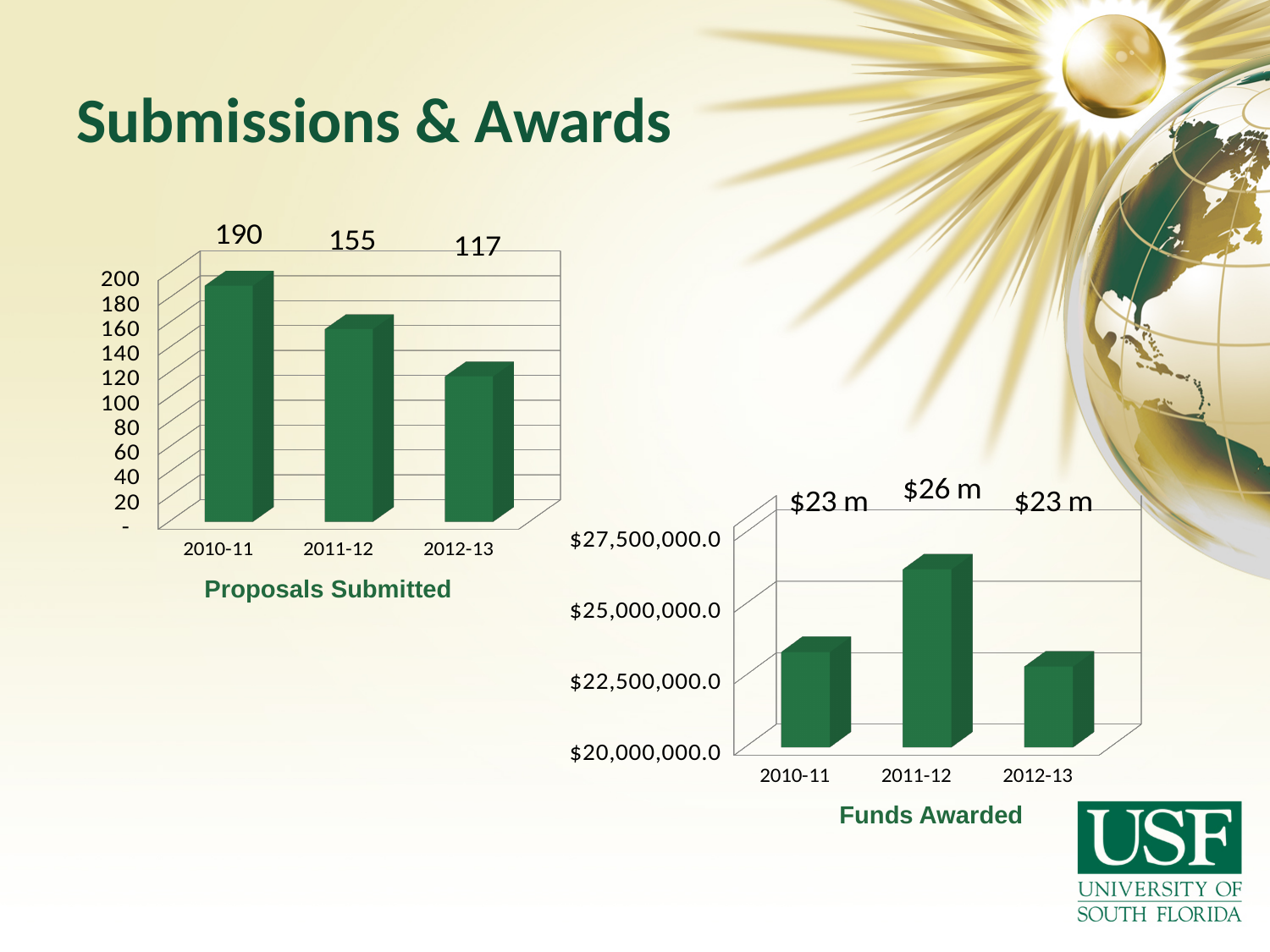
In the Funds Awarded chart, is the value for 2011-12 greater or less than $25,000,000.0? greater In the Proposals Submitted chart, which year has the lowest number of proposals? 2012-13 What kind of chart is the Funds Awarded chart? bar chart In the Funds Awarded chart, what is the value for 2011-12? $26 m In the Proposals Submitted chart, how many proposals were submitted in 2010-11? 190 In the Proposals Submitted chart, do the values rise or fall from 2010-11 to 2012-13? fall In the Proposals Submitted chart, how many years are shown? 3 In the Proposals Submitted chart, what is the value for 2012-13? 117 In the Funds Awarded chart, is the value for 2012-13 greater or less than $25,000,000.0? less In the Funds Awarded chart, which year has the highest funds awarded? 2011-12 In the Proposals Submitted chart, what is the difference between the 2010-11 and 2011-12 values? 35 In the Funds Awarded chart, what is the value for 2010-11? $23 m